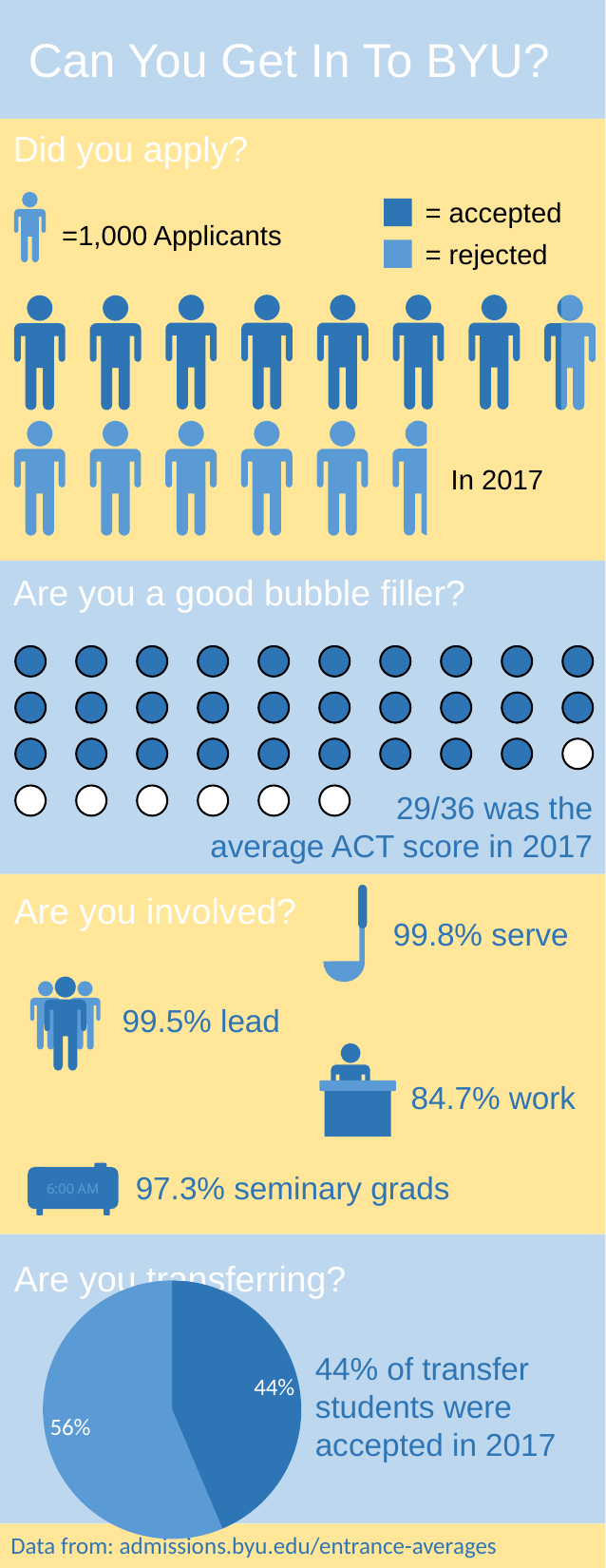
In the 'Are you a good bubble filler?' section, what was the average ACT score in 2017? 29/36 What kind of chart is shown in the 'Are you transferring?' section? pie chart How many slices does the 'Are you transferring?' pie chart have? 2 In the 'Did you apply?' pictograph, which group is larger, accepted or rejected? accepted In the 'Are you a good bubble filler?' section, how many circles are shown in total? 36 In the 'Did you apply?' pictograph, how many categories does the legend list? 2 In the 'Are you involved?' section, which activity has the lowest percentage? work In the 'Are you transferring?' pie chart, what is the difference in percentage points between the two slices? 12 In the 'Are you transferring?' pie chart, what is the value of the larger slice? 56% In the 'Are you involved?' section, what percentage of students are seminary grads? 97.3% In the 'Did you apply?' pictograph, how many applicants does one person icon represent? 1,000 Applicants In the 'Are you transferring?' pie chart, what percentage of transfer students were accepted in 2017? 44%